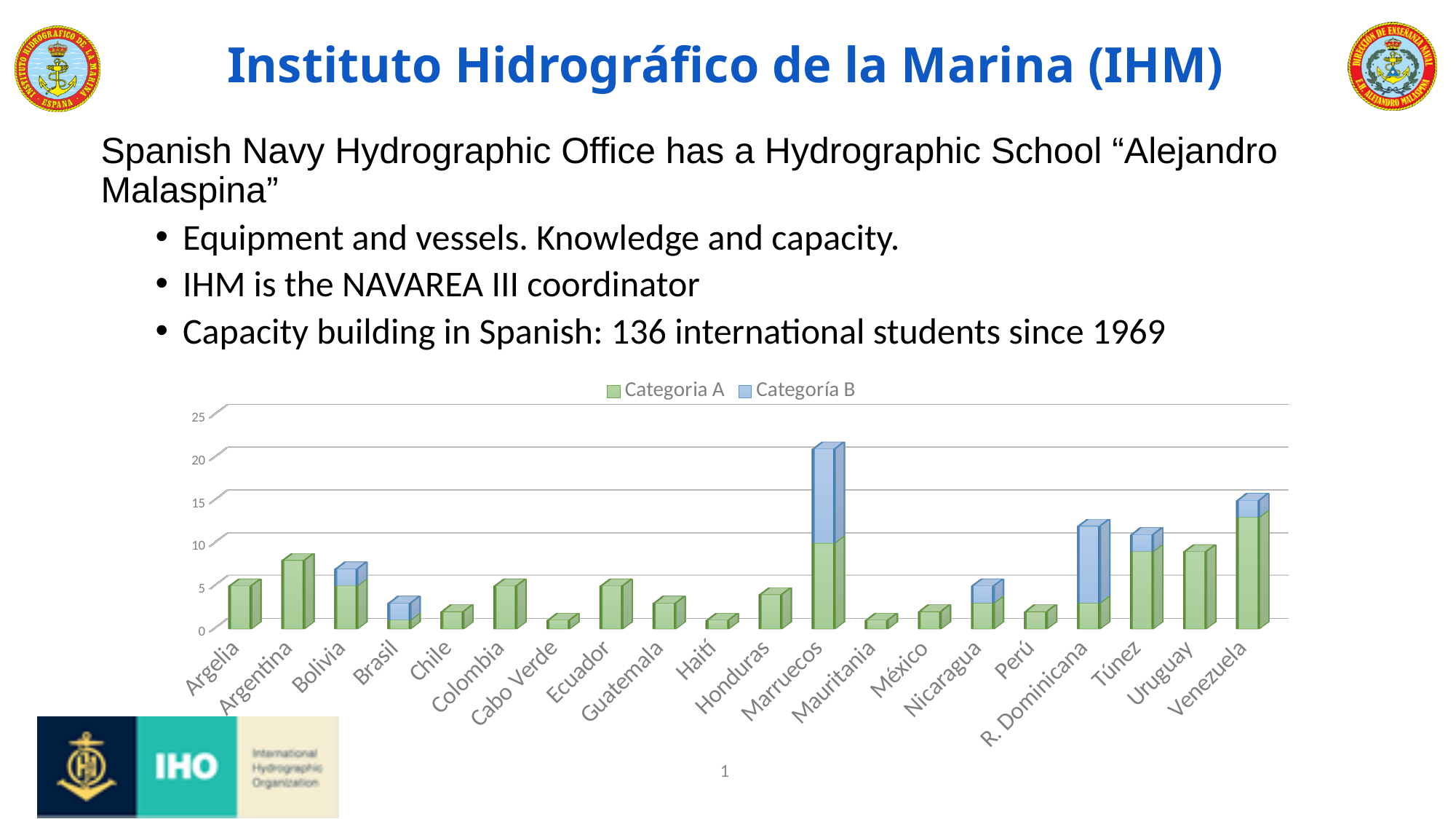
How many series does the chart legend list? 2 Which has the larger total bar, Argentina or Argelia? Argentina Is the total value for Argentina greater or less than 10? less What are the two series named in the chart legend? Categoria A and Categoría B Which has the larger total bar, Uruguay or Chile? Uruguay Which colour represents Categoría B in the chart? Blue Is the total value for Venezuela greater or less than 10? greater Is the total value for Marruecos greater or less than 15? greater How many countries are shown on the x axis of the chart? 20 What kind of chart is shown on the slide? Stacked bar chart Which country has the highest total bar in the chart? Marruecos